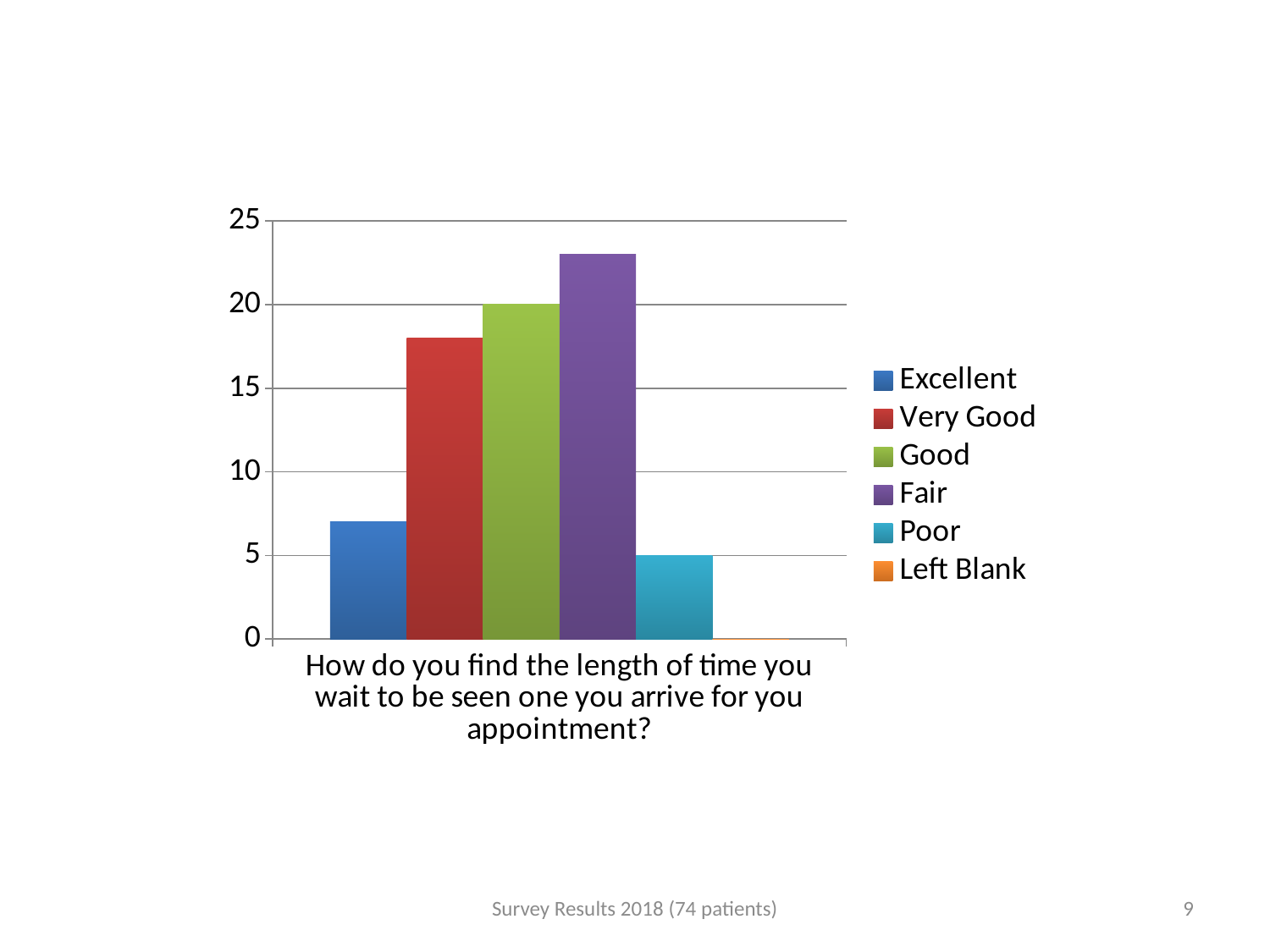
What kind of chart is shown on the slide? Bar chart How many series does the legend list? 6 Is the value for Excellent greater or less than 10? less Which response category has the highest bar? Fair Which is larger, the value for Very Good or the value for Good? Good Is the value for Fair greater or less than 20? greater Is the value for Very Good greater or less than 15? greater What colour is used for the Fair series in the legend? Purple Which is larger, the value for Excellent or the value for Poor? Excellent What is the difference between the values for Good and Poor? 15 What is the value for Good? 20 What is the value for Poor? 5